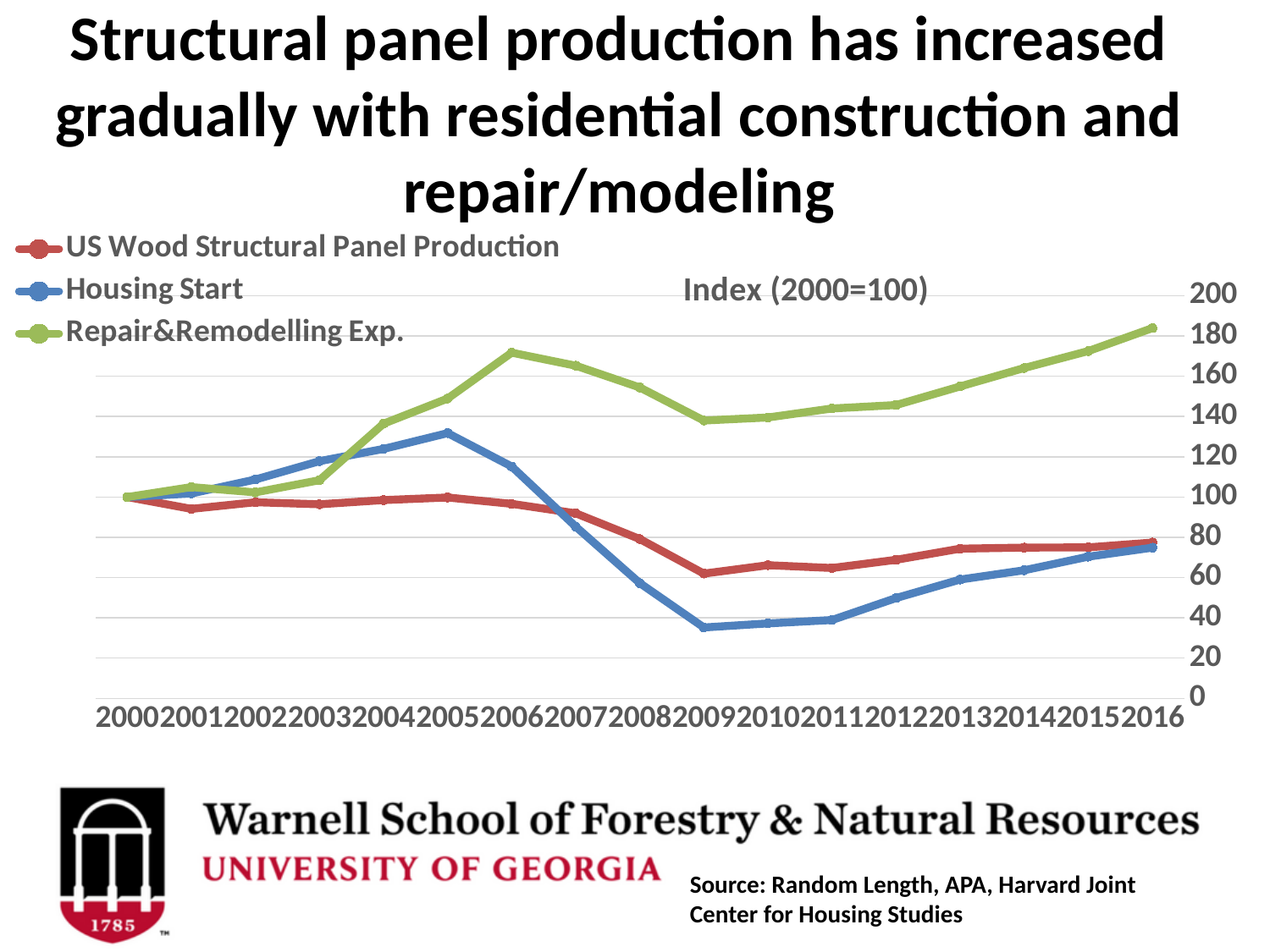
In 2005, which is larger: Housing Start or US Wood Structural Panel Production? Housing Start How many years are plotted along the x axis? 17 Is the value for US Wood Structural Panel Production in 2009 greater or less than 80? less What kind of chart is shown on the slide? line chart Is the value for Repair&Remodelling Exp. in 2016 greater or less than 160? greater Is the value for Housing Start in 2009 greater or less than 60? less What is the title shown above the chart's plot area? Index (2000=100) How many series does the legend list? 3 Which series has the highest value in 2016? Repair&Remodelling Exp. What is the value of Housing Start in 2000? 100 Which series has the lowest value in 2009? Housing Start Does the Housing Start series rise or fall between 2005 and 2009? fall